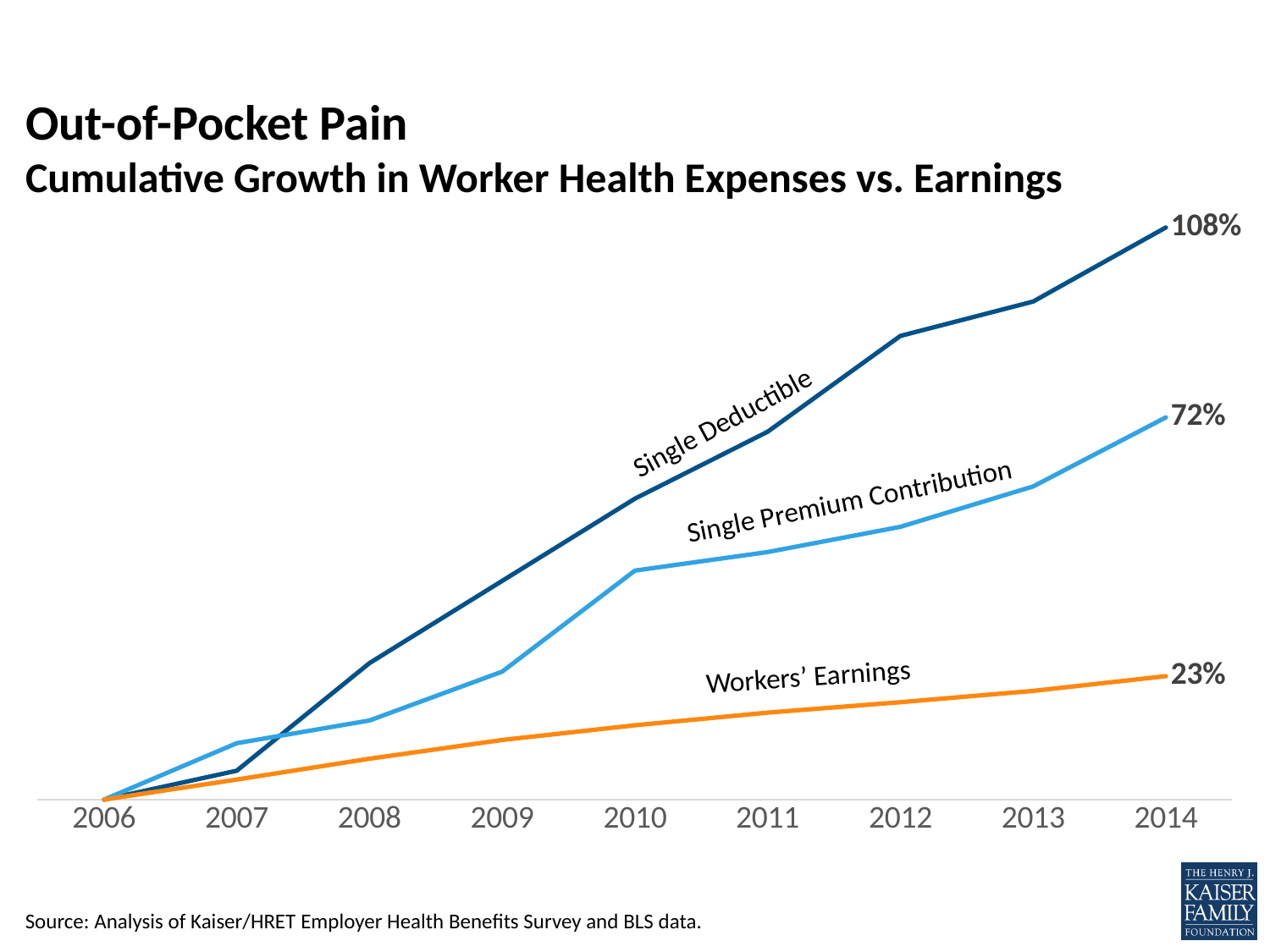
What is the cumulative growth in Workers' Earnings by 2014? 23% What is the cumulative growth in Single Premium Contribution by 2014? 72% What kind of chart is shown on the slide? Line chart How many years are shown on the x axis? 9 What is the cumulative growth in Single Deductible by 2014? 108% How many series are plotted on the chart? 3 In 2007, which is higher: Single Premium Contribution or Single Deductible? Single Premium Contribution Which series has the lowest value in 2014? Workers' Earnings What is the difference between the 2014 values for Single Deductible and Single Premium Contribution? 36 percentage points Which series has the highest value in 2014? Single Deductible Does the Single Deductible line rise or fall from 2006 to 2014? Rises What is the difference between the 2014 values for Single Deductible and Workers' Earnings? 85 percentage points